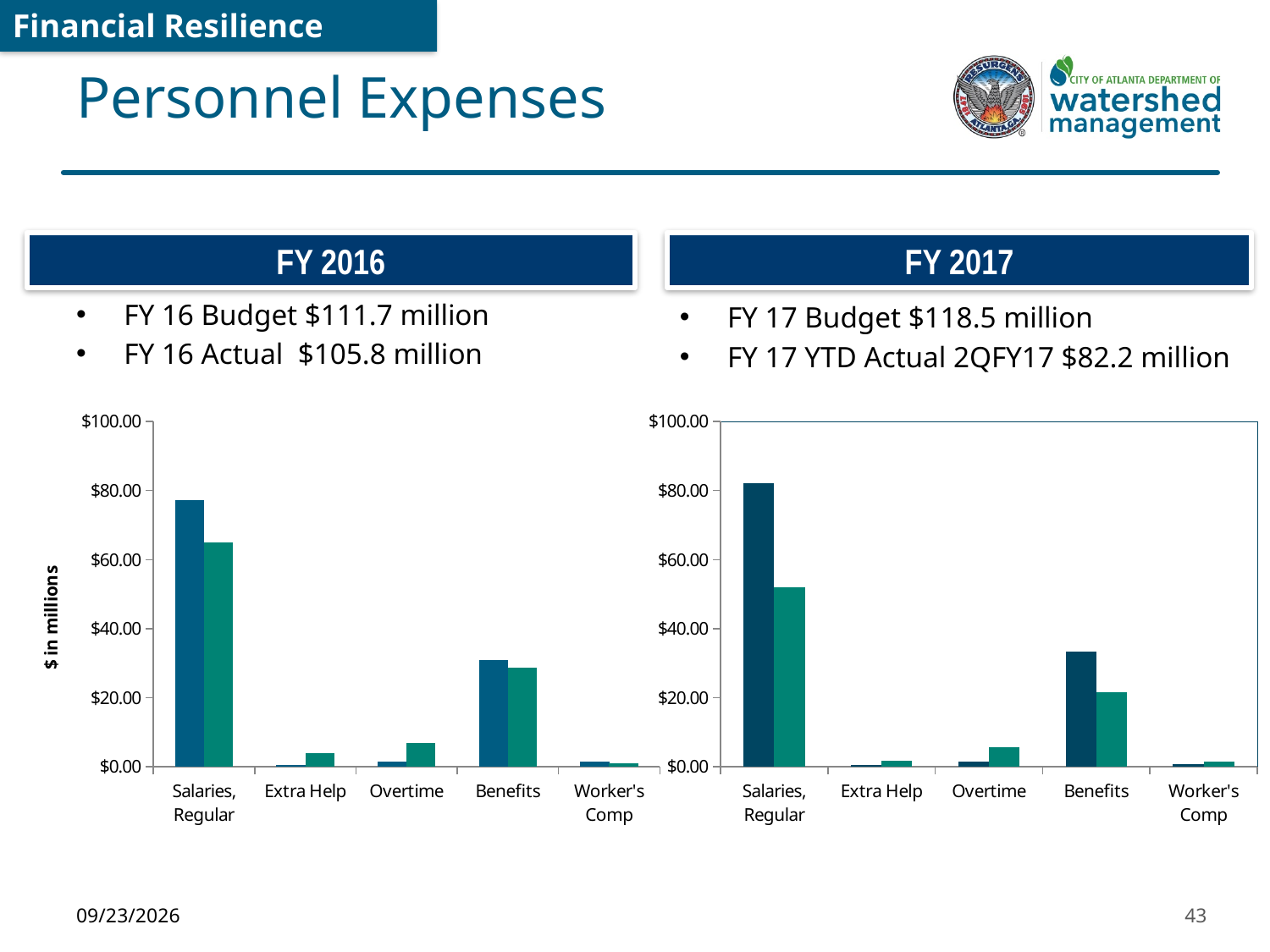
What is the label on the vertical axis of the FY 2016 chart? $ in millions In the FY 2017 chart, for Salaries, Regular, which bar is taller, the left (blue) bar or the right (green) bar? the left (blue) bar In the FY 2017 chart, is the value of the right (green) bar for Salaries, Regular greater or less than $60.00? less In the FY 2016 chart, which category has larger bars, Salaries, Regular or Benefits? Salaries, Regular How many categories are shown on the x axis of the FY 2017 chart? 5 In the FY 2016 chart, is the value of the left (blue) bar for Benefits greater or less than $20.00? greater In the FY 2017 chart, which category has the tallest bar? Salaries, Regular What kind of chart is the FY 2016 chart on the left? bar chart In the FY 2016 chart, is the value of the left (blue) bar for Salaries, Regular greater or less than $60.00? greater In the FY 2016 chart, which category has the tallest bar? Salaries, Regular